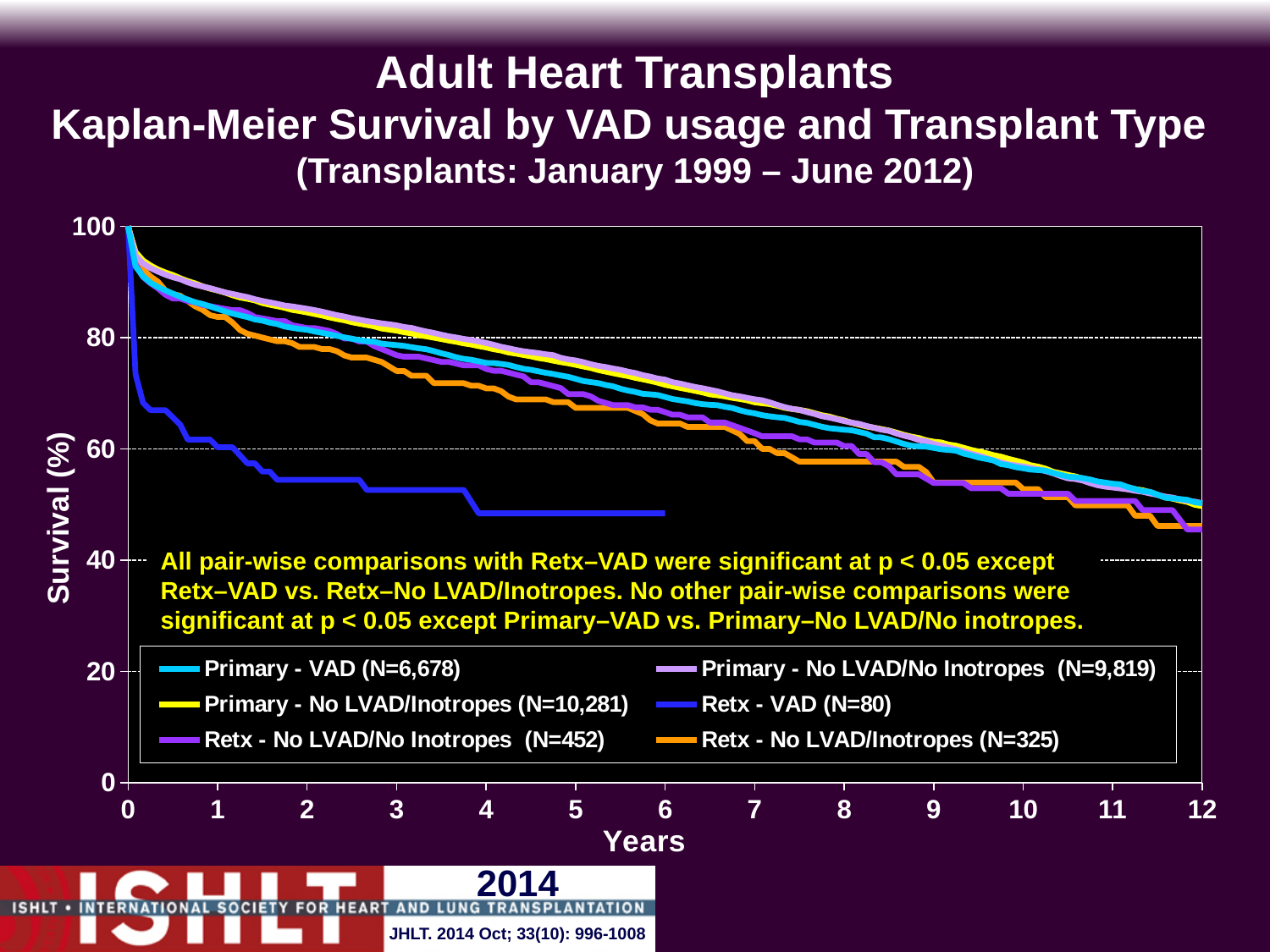
What is the label of the y axis? Survival (%) Do the survival curves rise or fall as years increase? fall Is the survival for Retx - No LVAD/Inotropes at 12 years greater or less than 60? less Which series has the lowest survival at 6 years? Retx - VAD Is the survival for Primary - No LVAD/Inotropes at 6 years greater or less than 60? greater How many series does the legend list? 6 At 3 years, which has higher survival: Primary - No LVAD/No Inotropes or Retx - VAD? Primary - No LVAD/No Inotropes What kind of chart is shown on the slide? line chart What is the maximum value shown on the x axis (Years)? 12 Is the survival for Primary - No LVAD/No Inotropes at 1 year greater or less than 80? greater What is the N for the Retx - VAD group in the legend? N=80